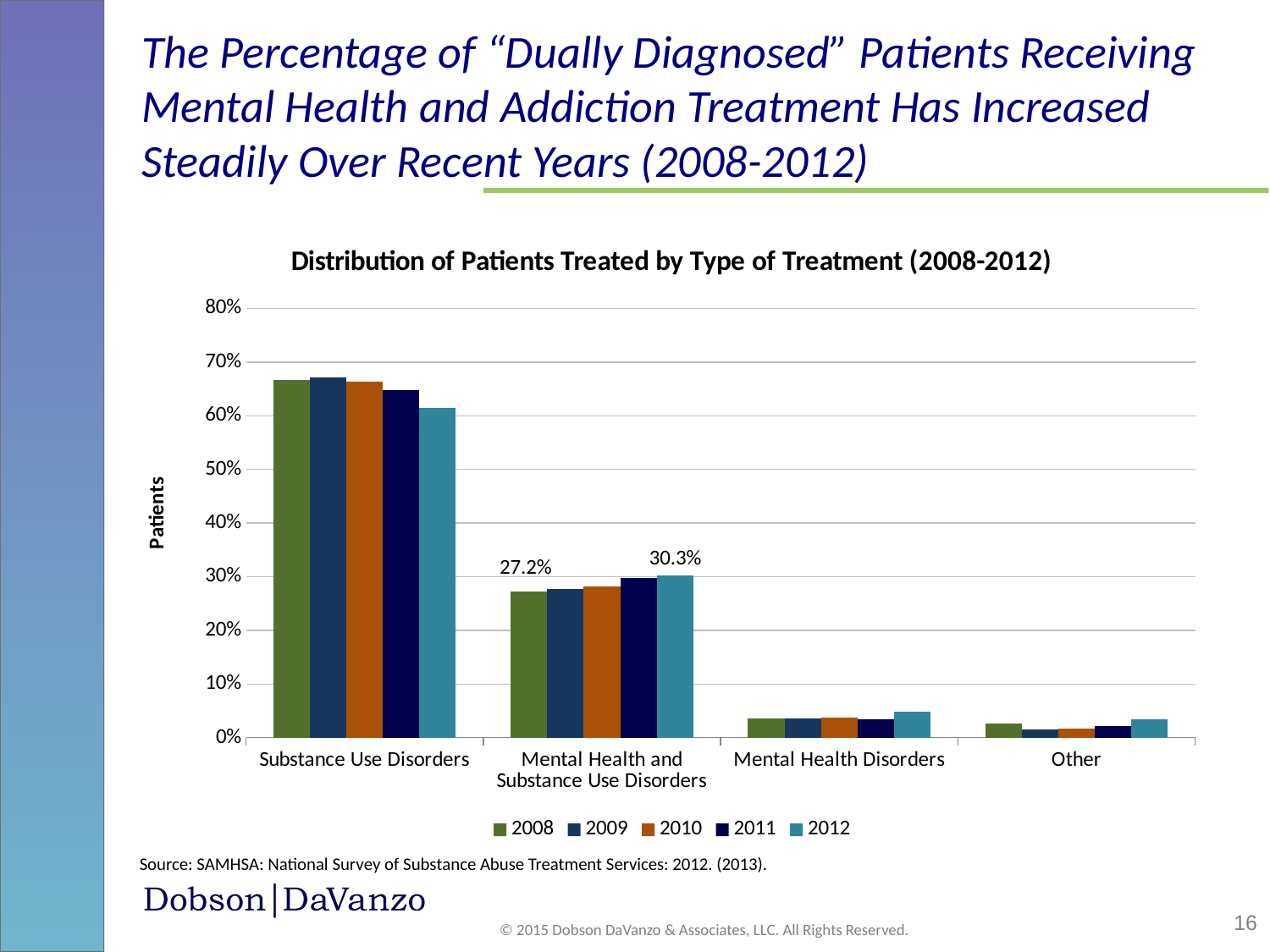
Is the value for Mental Health Disorders in 2012 greater or less than 10%? less In the Mental Health and Substance Use Disorders category, which year has the larger value, 2008 or 2012? 2012 How many series does the legend list? 5 Is the value for Substance Use Disorders in 2012 greater or less than 50%? greater Which treatment category has the highest values across all years? Substance Use Disorders What is the value for 2008 in the Mental Health and Substance Use Disorders category? 27.2% What kind of chart is shown on the slide? Bar chart Which treatment category has the lowest values across all years? Other How many treatment categories are shown on the x axis? 4 By how many percentage points did the Mental Health and Substance Use Disorders value change from 2008 to 2012? 3.1 percentage points What is the value for 2012 in the Mental Health and Substance Use Disorders category? 30.3% Do the values for Mental Health and Substance Use Disorders rise or fall from 2008 to 2012? Rise